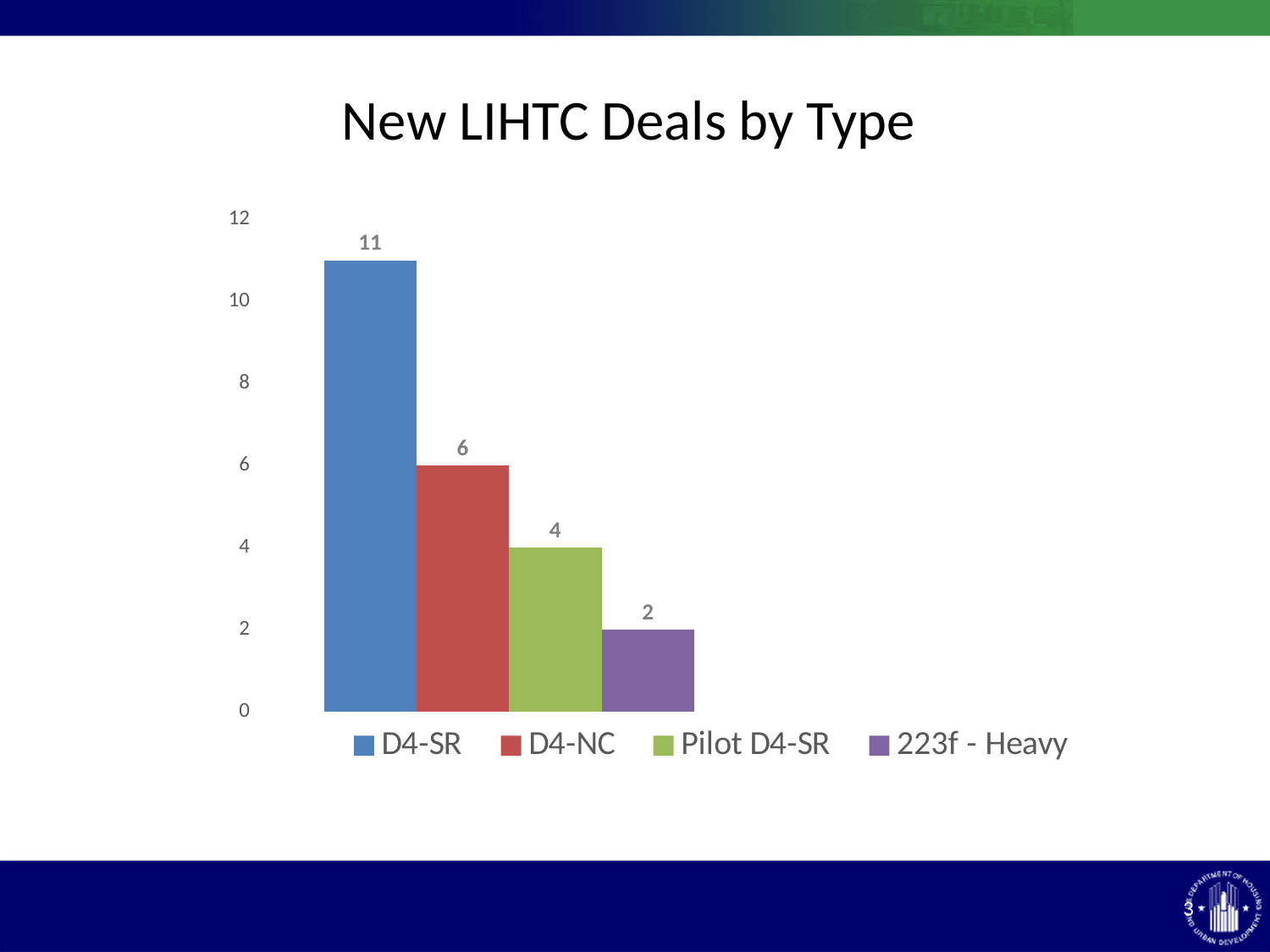
What is the difference between the values for D4-SR and D4-NC? 5 Which is larger, the value for Pilot D4-SR or the value for 223f - Heavy? Pilot D4-SR Is the value for D4-SR greater or less than 10? greater Which deal type has the highest value? D4-SR How many bars are shown in the chart? 4 What is the title of the chart? New LIHTC Deals by Type Which deal type has the lowest value? 223f - Heavy What is the value for Pilot D4-SR? 4 What is the value for D4-NC? 6 What kind of chart is shown on the slide? Bar chart What is the value for 223f - Heavy? 2 What is the value for D4-SR? 11